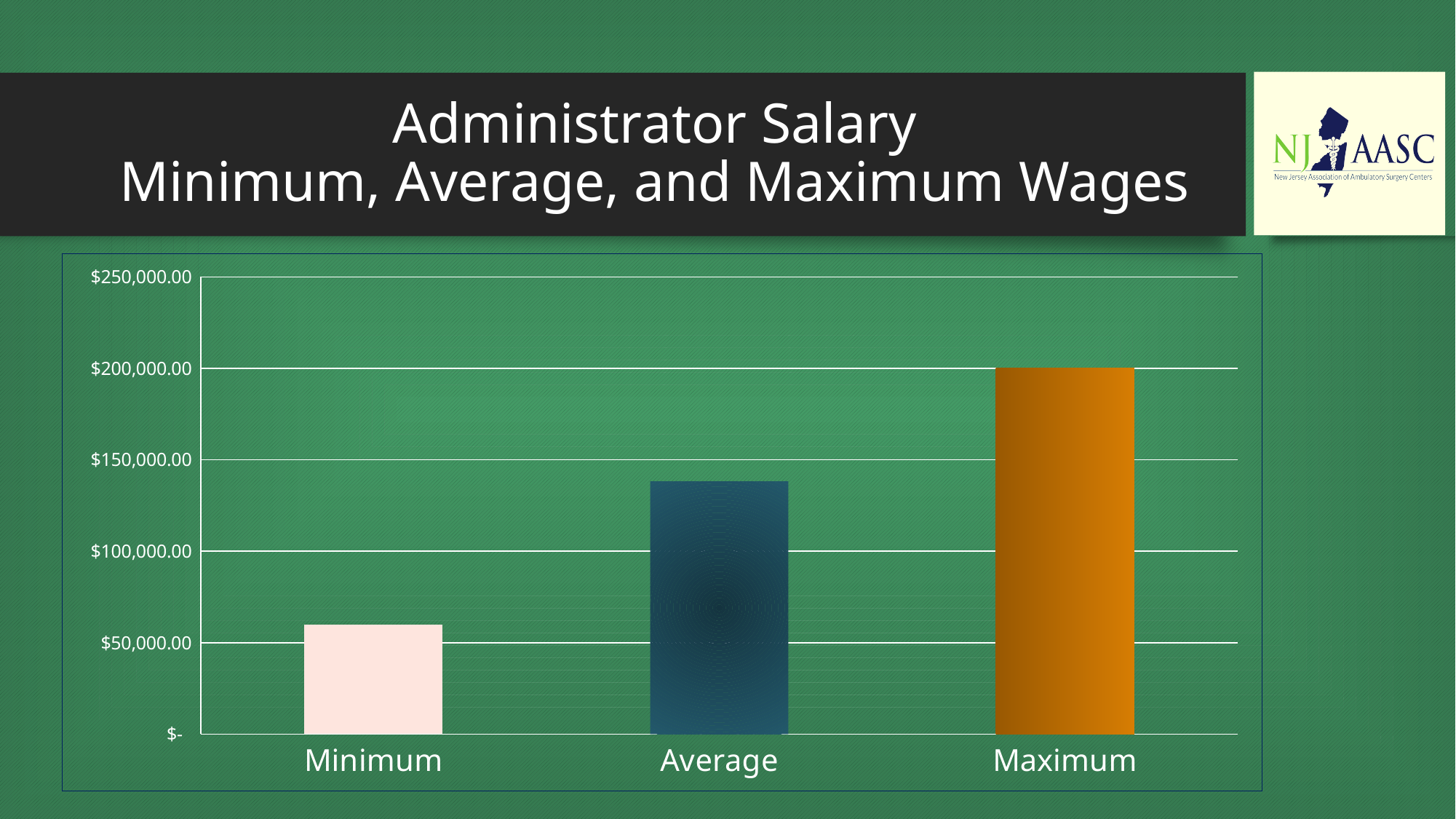
Is the value for Minimum greater or less than $100,000.00? less What is the title of the slide containing the chart? Administrator Salary Minimum, Average, and Maximum Wages How many categories are plotted on the chart? 3 Is the value for Minimum greater or less than $50,000.00? greater What kind of chart is shown on the slide? bar chart Do the values rise or fall from Minimum to Maximum along the x axis? rise Which category has the lowest value? Minimum Which is larger, the value for Average or the value for Minimum? Average Which category has the highest value? Maximum Is the value for Average greater or less than $150,000.00? less What is the value for Maximum? $200,000.00